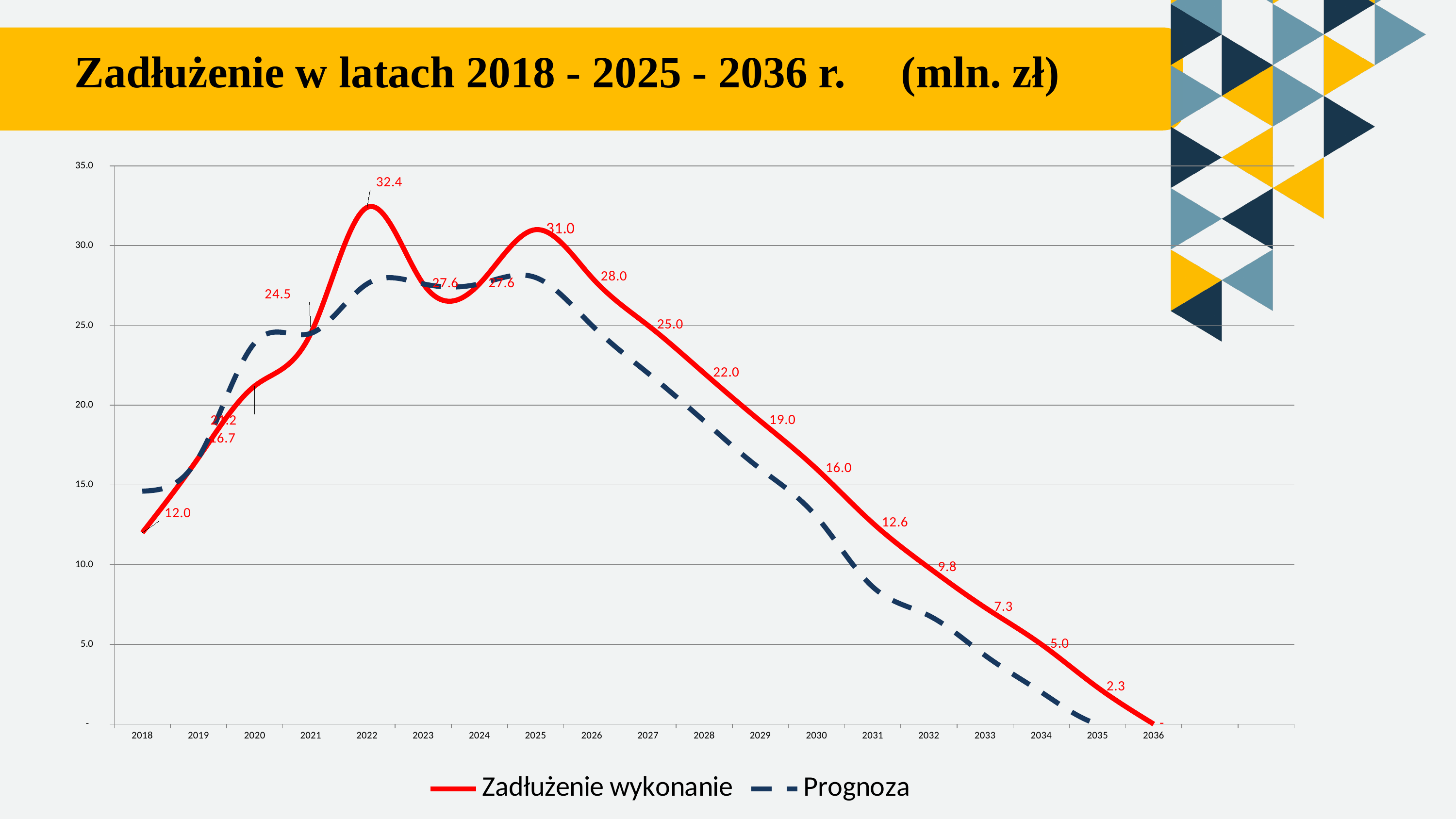
What is the value of Zadłużenie wykonanie in 2022? 32.4 What is the value of Zadłużenie wykonanie in 2035? 2.3 How many series does the legend list? 2 What is the value of Zadłużenie wykonanie in 2018? 12.0 How many years are shown on the x axis? 19 Is the Prognoza value for 2022 greater or less than 25.0? greater What type of chart is shown on the slide? line chart What is the difference between the Zadłużenie wykonanie values for 2022 and 2025? 1.4 Which is larger for Zadłużenie wykonanie: the value in 2026 or the value in 2028? 2026 What are the names of the two series in the legend? Zadłużenie wykonanie and Prognoza What is the value of Zadłużenie wykonanie in 2025? 31.0 In which year does Zadłużenie wykonanie reach its highest value? 2022